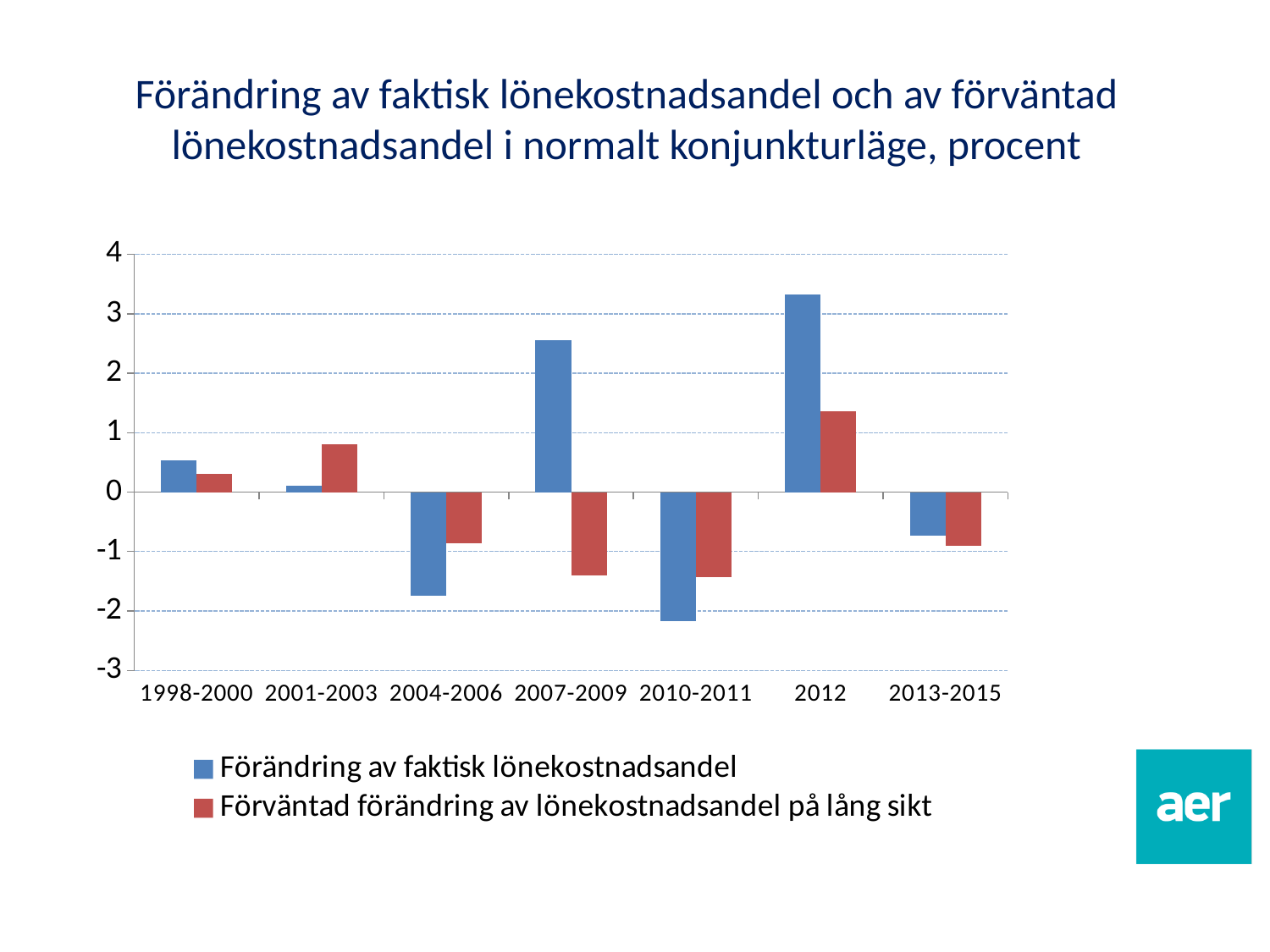
In which period is the value for 'Förväntad förändring av lönekostnadsandel på lång sikt' highest? 2012 In which period is the value for 'Förändring av faktisk lönekostnadsandel' lowest? 2010-2011 What kind of chart is shown on the slide? bar chart Is the value for 'Förväntad förändring av lönekostnadsandel på lång sikt' in 2012 greater or less than 1? greater In 2001-2003, which series has the larger value? Förväntad förändring av lönekostnadsandel på lång sikt How many period categories are shown on the x axis? 7 How many series does the legend list? 2 Which colour represents 'Förändring av faktisk lönekostnadsandel' in the legend? blue Is the value for 'Förändring av faktisk lönekostnadsandel' in 2010-2011 greater or less than -2? less Is the value for 'Förändring av faktisk lönekostnadsandel' in 2007-2009 greater or less than 2? greater In which period is the value for 'Förändring av faktisk lönekostnadsandel' highest? 2012